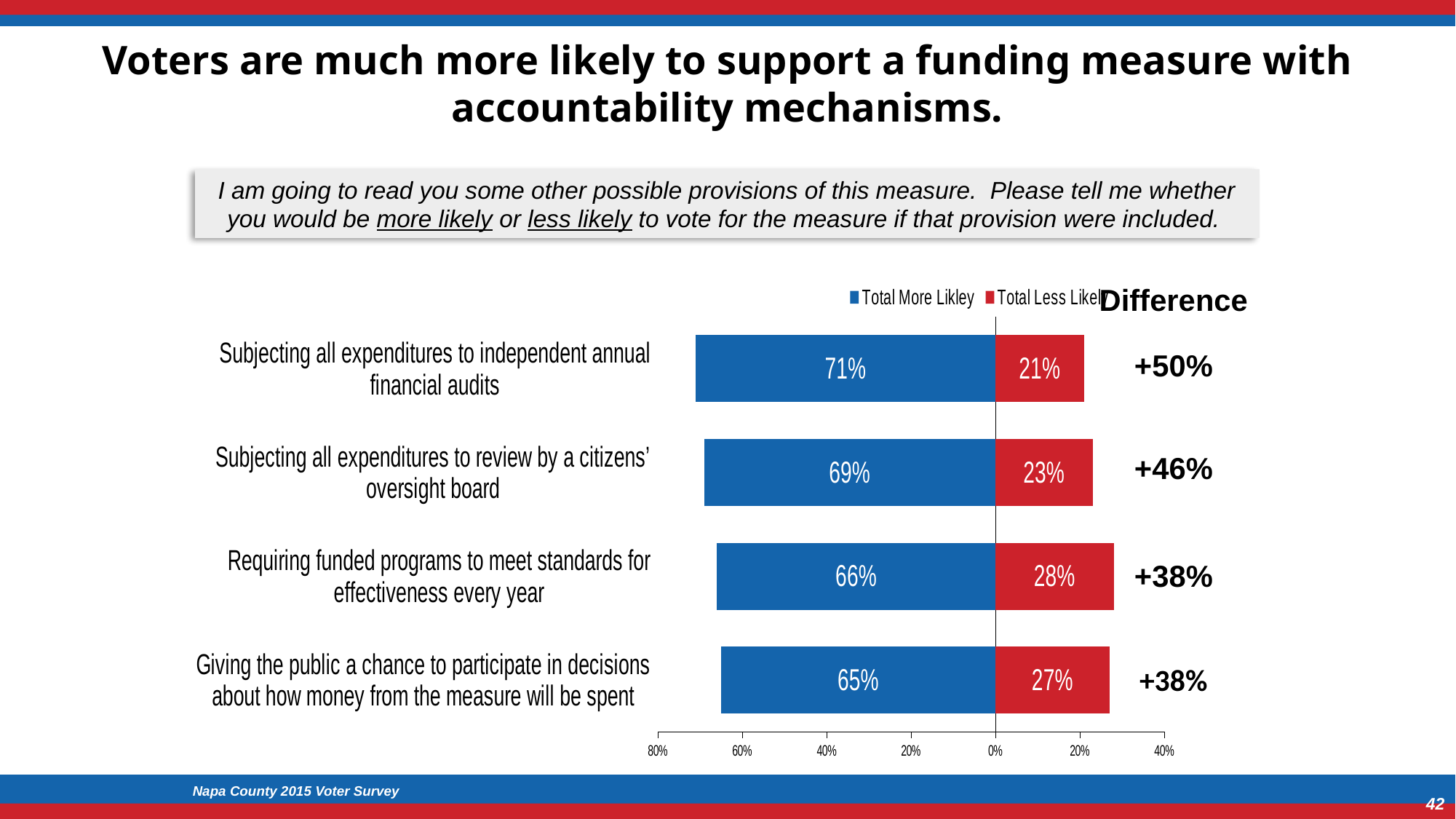
What is the Total Less Likely value for requiring funded programs to meet standards for effectiveness every year? 28% Which provision has the highest Total More Likely percentage? Subjecting all expenditures to independent annual financial audits What percentage of voters said they would be more likely to vote for the measure if it included subjecting all expenditures to independent annual financial audits? 71% What is the Total More Likely value for giving the public a chance to participate in decisions about how money from the measure will be spent? 65% What is the difference between the Total More Likely and Total Less Likely values for subjecting all expenditures to review by a citizens' oversight board? 46% What colour are the Total More Likely bars? Blue Which is larger: the Total Less Likely value for requiring funded programs to meet standards for effectiveness every year, or the Total Less Likely value for giving the public a chance to participate in decisions about how money will be spent? Requiring funded programs to meet standards for effectiveness every year How many series does the chart legend list? 2 What kind of chart is shown on the slide? Bar chart Which provision has the lowest Total Less Likely percentage? Subjecting all expenditures to independent annual financial audits How many provisions are shown in the chart? 4 Is the Total More Likely value for subjecting all expenditures to review by a citizens' oversight board greater or less than 60%? greater